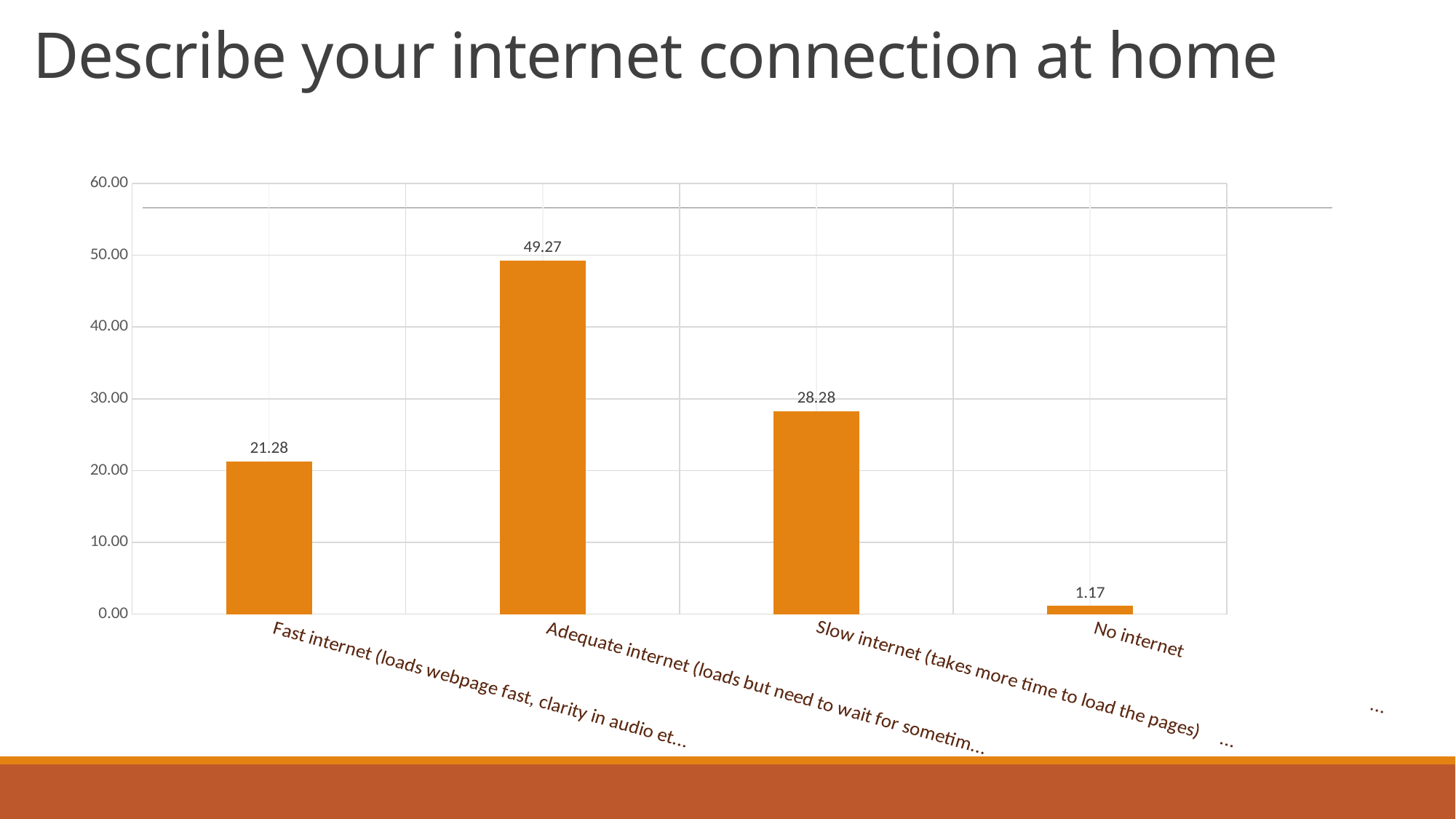
Which category has the highest value? Adequate internet What is the value for No internet? 1.17 What is the value for Fast internet? 21.28 Which category has the lowest value? No internet Which is larger, the value for Fast internet or the value for Slow internet? Slow internet What kind of chart is shown on the slide? bar chart How many categories are shown in the chart? 4 Is the value for Adequate internet greater or less than 40.00? greater What is the value for Adequate internet? 49.27 What is the value for Slow internet? 28.28 What is the difference between the values for Slow internet and Fast internet? 7.00 What is the difference between the values for Adequate internet and Slow internet? 20.99